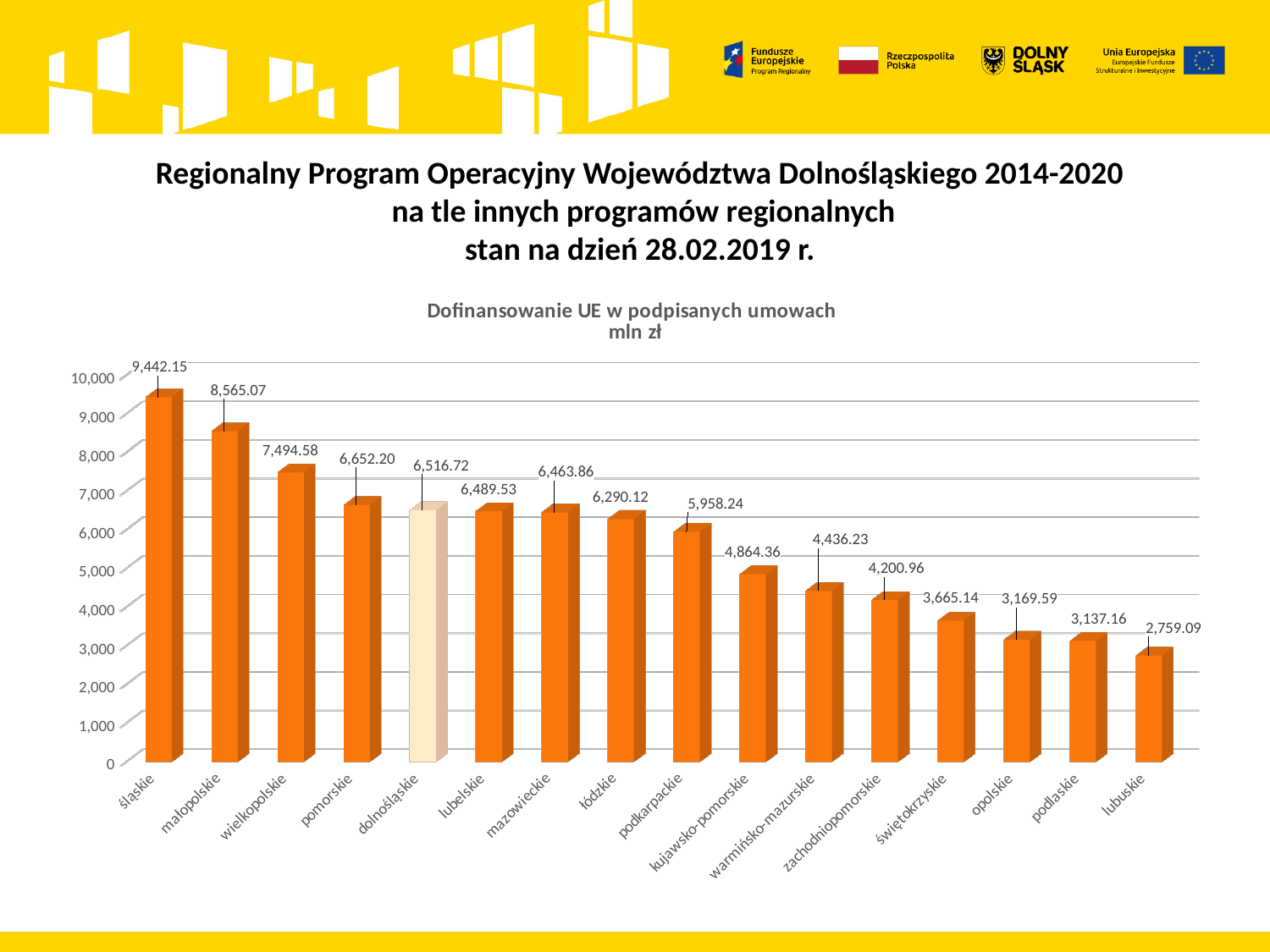
Which region's bar is shown in a different (lighter) colour from the others? dolnośląskie What kind of chart is this? bar chart What is the value for dolnośląskie? 6,516.72 Do the values rise or fall from left to right along the x axis? fall Which is larger, the value for pomorskie or the value for podkarpackie? pomorskie Which region has the lowest value? lubuskie How many regions are shown on the chart? 16 What is the difference between the values for śląskie and małopolskie? 877.08 What is the value for lubuskie? 2,759.09 Which region has the highest value? śląskie What is the difference between the values for dolnośląskie and lubelskie? 27.19 What is the value for śląskie? 9,442.15